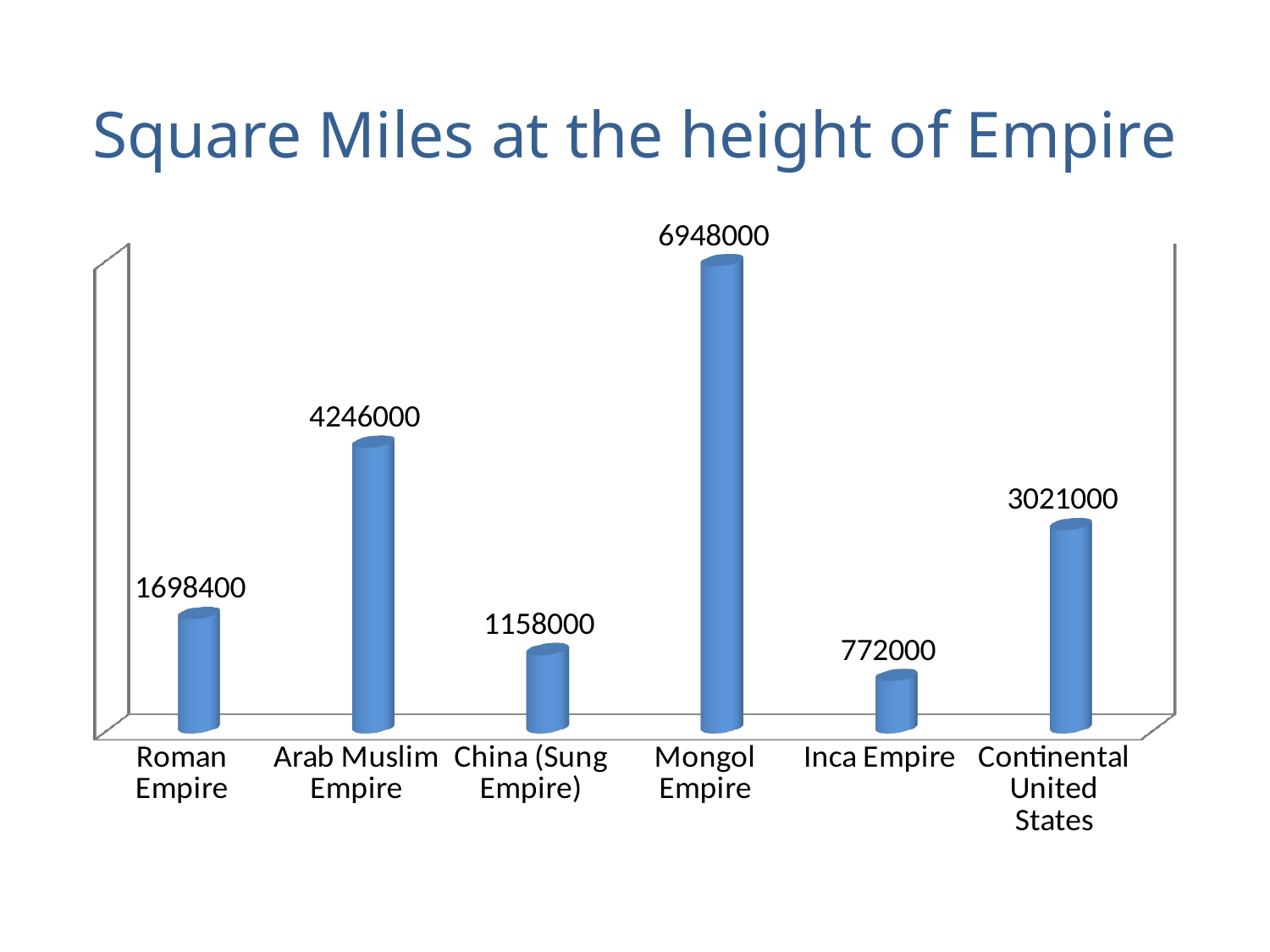
What is the value for the Mongol Empire? 6948000 Which category has the highest value? Mongol Empire Which category has the lowest value? Inca Empire What is the value for the Inca Empire? 772000 What is the value for the Roman Empire? 1698400 What is the difference between the Mongol Empire and the Arab Muslim Empire? 2702000 How many categories are shown in the chart? 6 Which is larger, the Arab Muslim Empire or the Continental United States? Arab Muslim Empire What is the value for the Continental United States? 3021000 What is the title of the slide? Square Miles at the height of Empire What is the difference between the Roman Empire and China (Sung Empire)? 540400 What kind of chart is shown on the slide? Bar chart